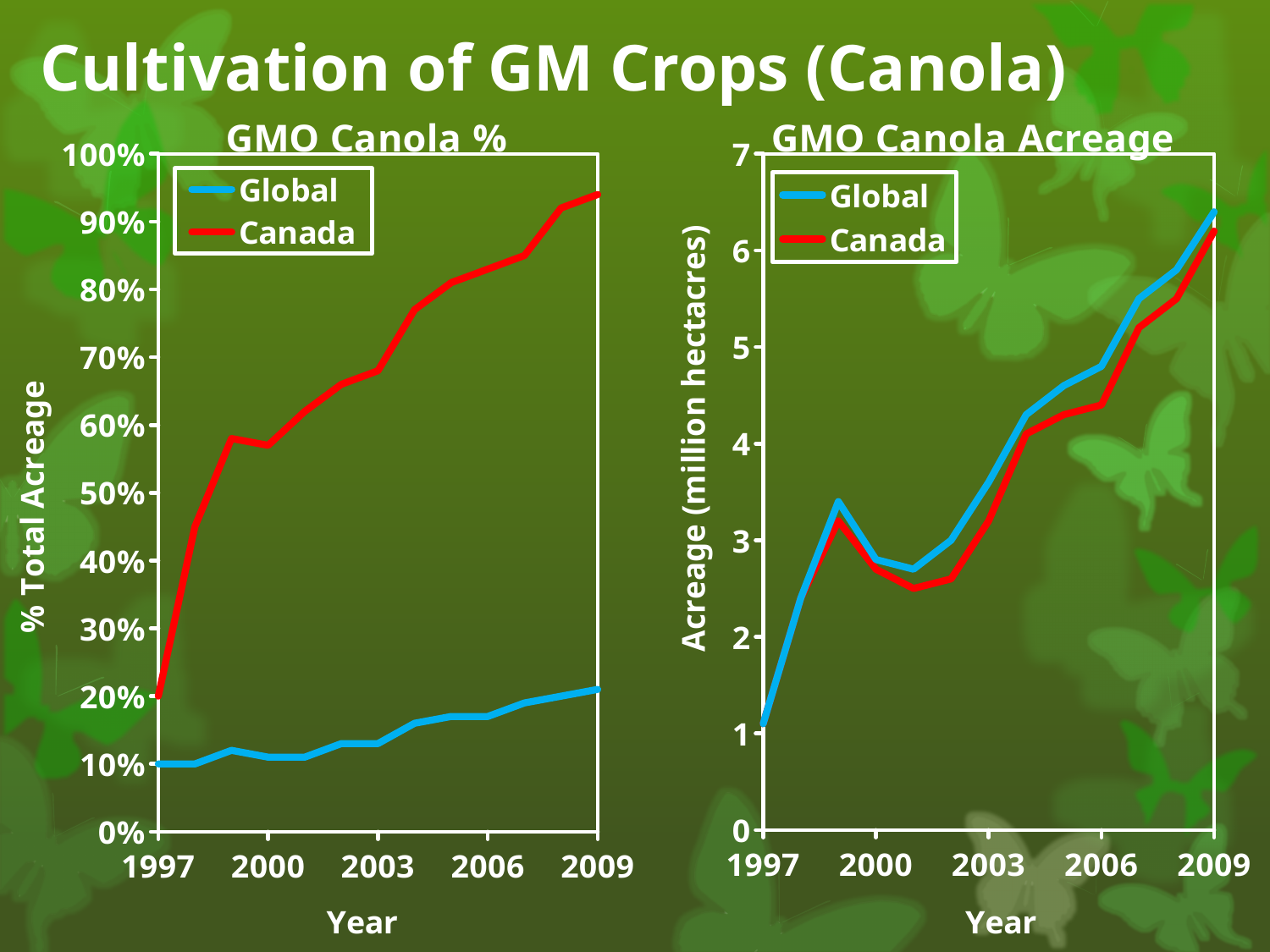
What is the y-axis title of the GMO Canola Acreage chart? Acreage (million hectacres) What is the x-axis title of the GMO Canola % chart? Year In the GMO Canola Acreage chart, is the Global value for 2009 greater or less than 6? greater In the GMO Canola Acreage chart, which series is higher in 2006, Global or Canada? Global In the GMO Canola Acreage chart, does the Global line rise or fall between 1999 and 2001? Falls What kind of chart is the GMO Canola % chart on the left? Line chart In the GMO Canola Acreage chart, is the Global value for 1997 greater or less than 2? less In the GMO Canola % chart, is the Canada value for 2009 greater or less than 90%? greater In the GMO Canola % chart, does the Canada line rise or fall from 1997 to 2009? Rises How many series does the legend of the GMO Canola Acreage chart list? 2 In the GMO Canola % chart, which series is higher in 2009, Global or Canada? Canada